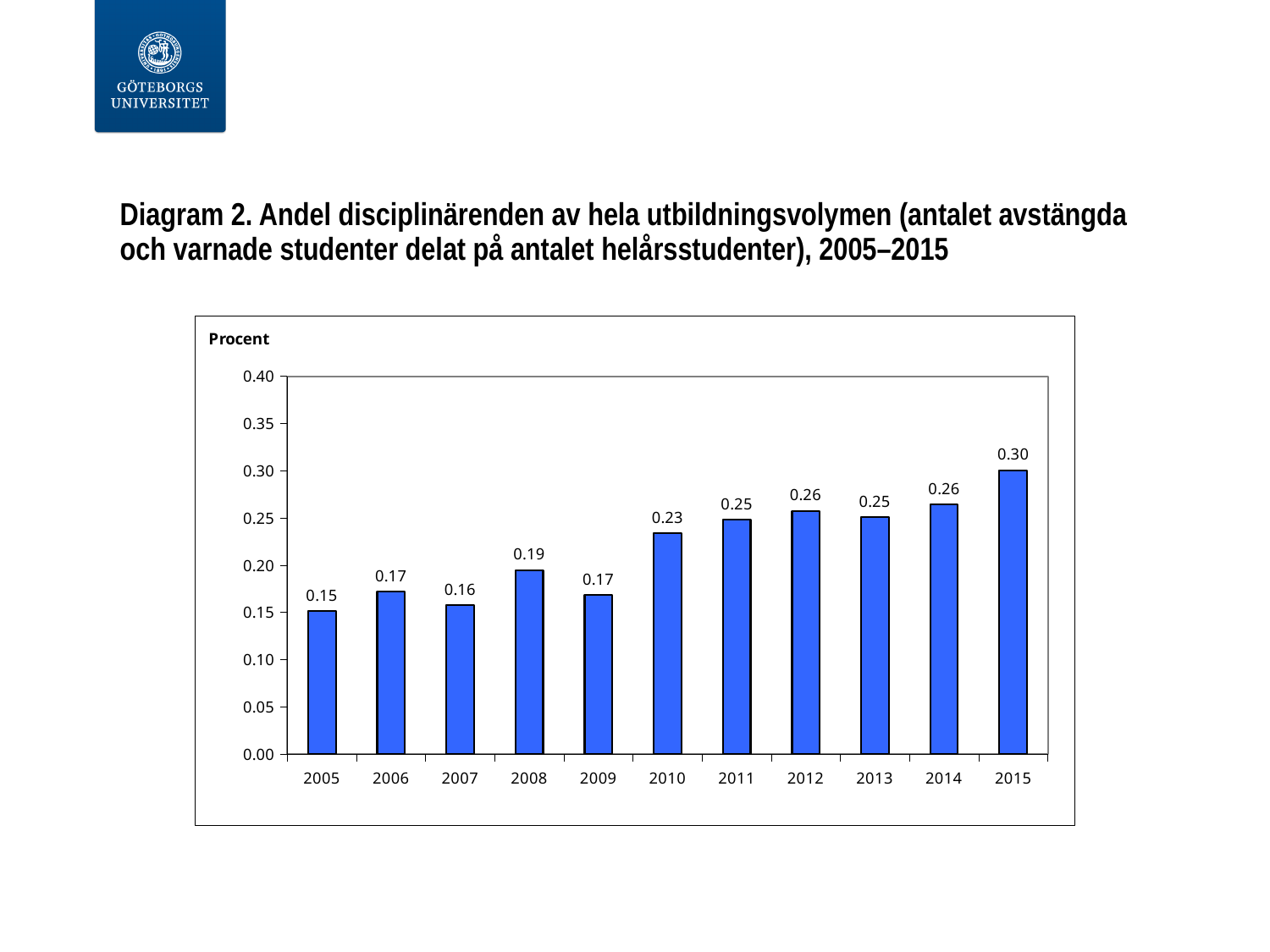
What label is shown on the y axis of the chart? Procent Is the value for 2012 greater or less than 0.20? greater What is the value for 2005? 0.15 What is the difference between the values for 2015 and 2005? 0.15 Which year has the lowest value? 2005 What is the value for 2015? 0.30 Which is larger, the value for 2008 or the value for 2009? 2008 What kind of chart is shown on the slide? Bar chart How many years are shown on the x axis? 11 What is the value for 2010? 0.23 Which year has the highest value? 2015 Do the values generally rise or fall from 2005 to 2015? Rise